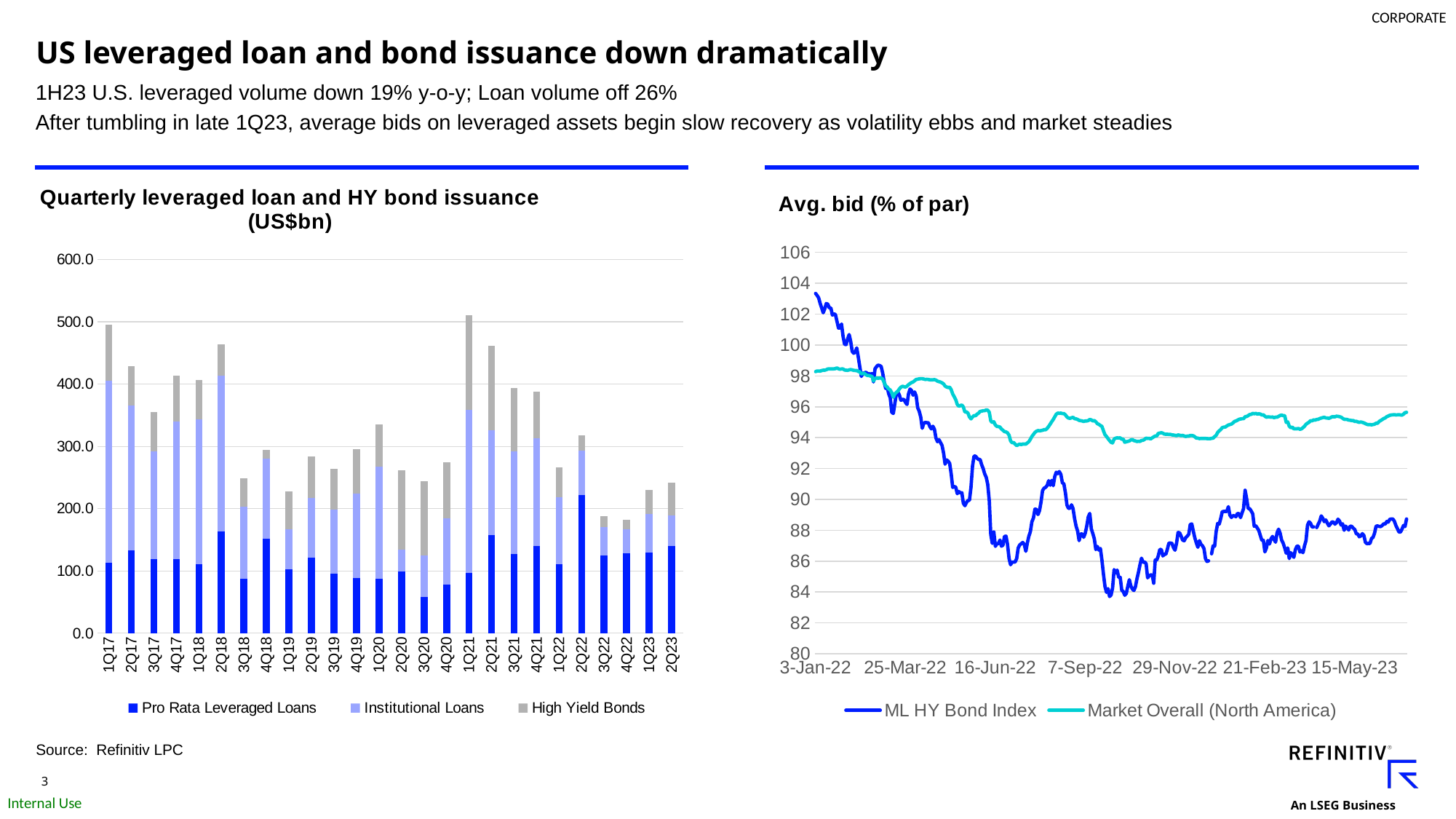
In the 'Avg. bid (% of par)' chart, which series is higher at 15-May-23, ML HY Bond Index or Market Overall (North America)? Market Overall (North America) How many series does the legend of the 'Avg. bid (% of par)' chart list? 2 In the 'Quarterly leveraged loan and HY bond issuance (US$bn)' chart, is the total bar for 2Q23 greater or less than 300.0? less What kind of chart is the 'Quarterly leveraged loan and HY bond issuance (US$bn)' chart? Stacked bar chart In the 'Quarterly leveraged loan and HY bond issuance (US$bn)' chart, is the total bar for 1Q17 greater or less than 400.0? greater In the 'Avg. bid (% of par)' chart, does the ML HY Bond Index rise or fall between 3-Jan-22 and 7-Sep-22? Fall In the 'Quarterly leveraged loan and HY bond issuance (US$bn)' chart, is the Pro Rata Leveraged Loans value for 2Q22 greater or less than 200.0? greater In the 'Quarterly leveraged loan and HY bond issuance (US$bn)' chart, which series is shown in grey? High Yield Bonds How many quarters are shown on the x axis of the 'Quarterly leveraged loan and HY bond issuance (US$bn)' chart? 26 What kind of chart is the 'Avg. bid (% of par)' chart? Line chart How many series does the legend of the 'Quarterly leveraged loan and HY bond issuance (US$bn)' chart list? 3